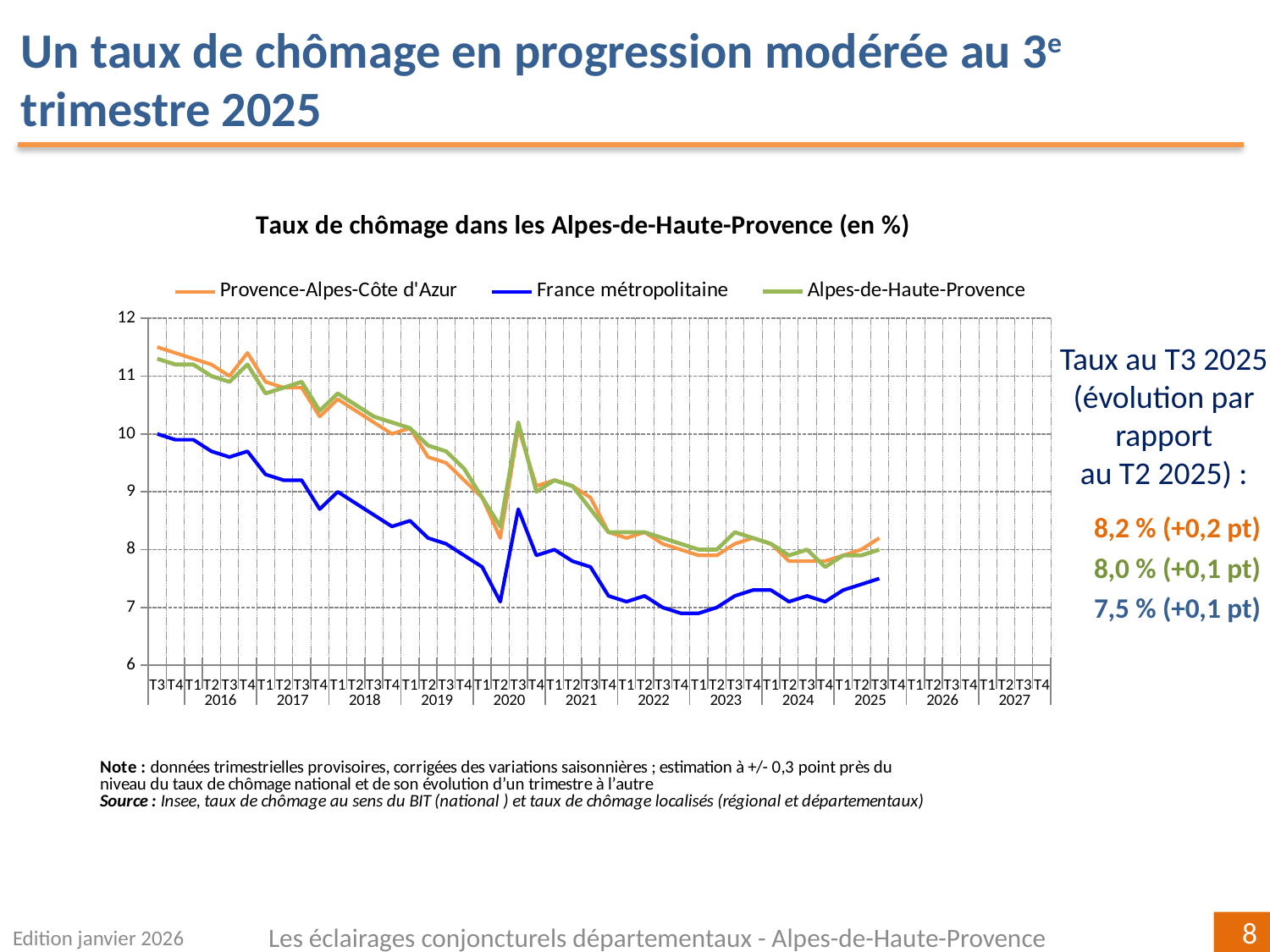
How many series does the legend list? 3 Overall, do the unemployment rates rise or fall between 2015 and 2025? fall What kind of chart is shown on the slide? line chart What is the difference between the Provence-Alpes-Côte d'Azur rate and the France métropolitaine rate at T3 2025? 0,7 pt What is the title of the chart? Taux de chômage dans les Alpes-de-Haute-Provence (en %) Is the value for France métropolitaine at T3 2015 greater or less than 9? greater Which series has the lowest value at T3 2025? France métropolitaine Which series has the highest value at T3 2025? Provence-Alpes-Côte d'Azur By how much did the Alpes-de-Haute-Provence rate change between T2 2025 and T3 2025? +0,1 pt What is the unemployment rate for France métropolitaine at T3 2025? 7,5 % What is the unemployment rate for Alpes-de-Haute-Provence at T3 2025? 8,0 % What is the unemployment rate for Provence-Alpes-Côte d'Azur at T3 2025? 8,2 %